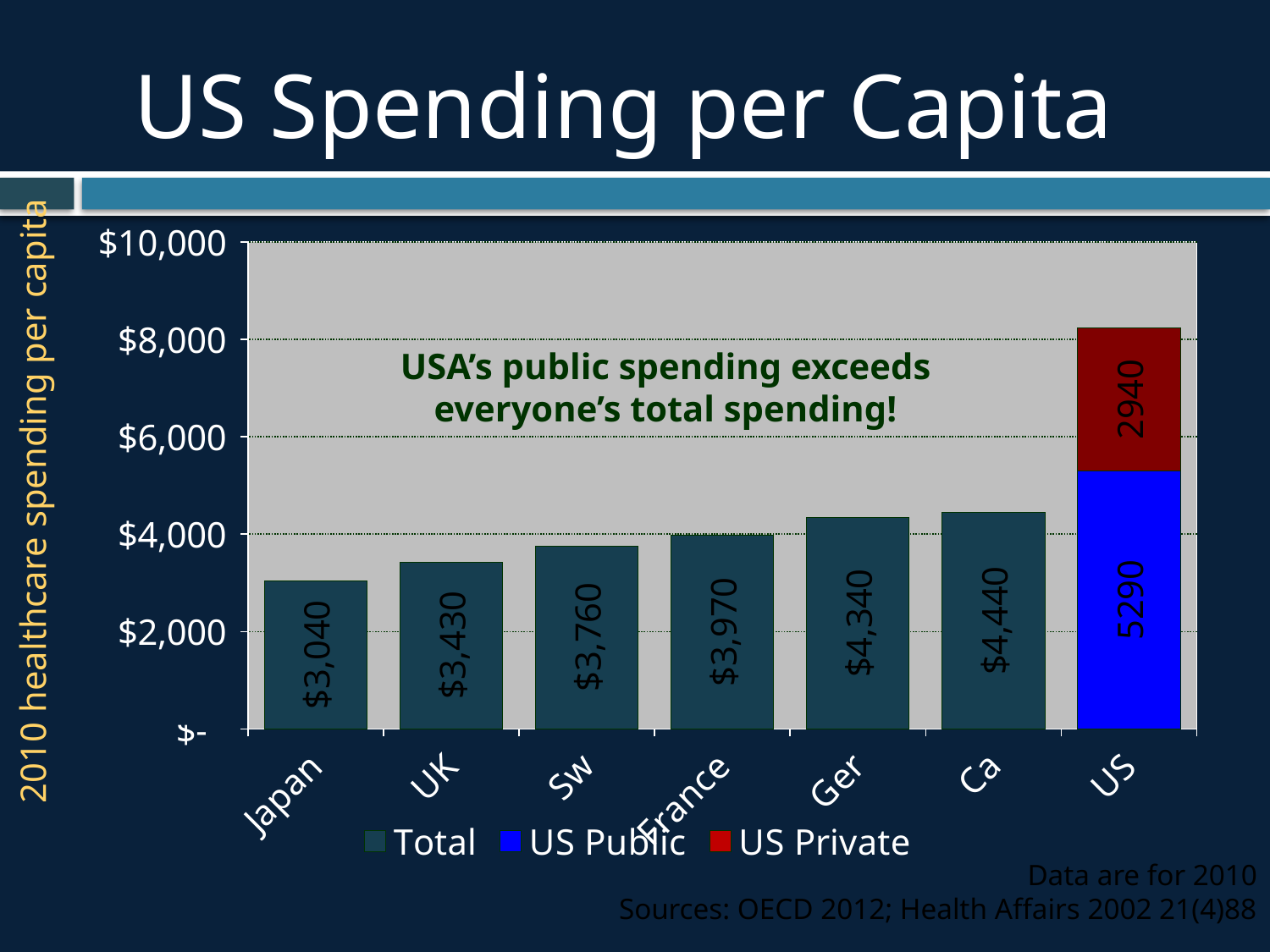
What kind of chart is shown on the slide? Bar chart Which has higher total spending per capita, France or Sw? France What is the US Public spending per capita shown on the US bar? 5290 What is the total of the stacked US bar (US Public plus US Private)? 8230 Which country has the lowest total healthcare spending per capita? Japan Which country has the highest healthcare spending per capita? US What is the total healthcare spending per capita for Ger? $4,340 What is the US Private spending per capita shown on the US bar? 2940 What is the difference between the total spending per capita of Ca and UK? $1,010 How many series does the legend list? 3 What is the total healthcare spending per capita for Japan? $3,040 How many countries are shown on the x axis? 7